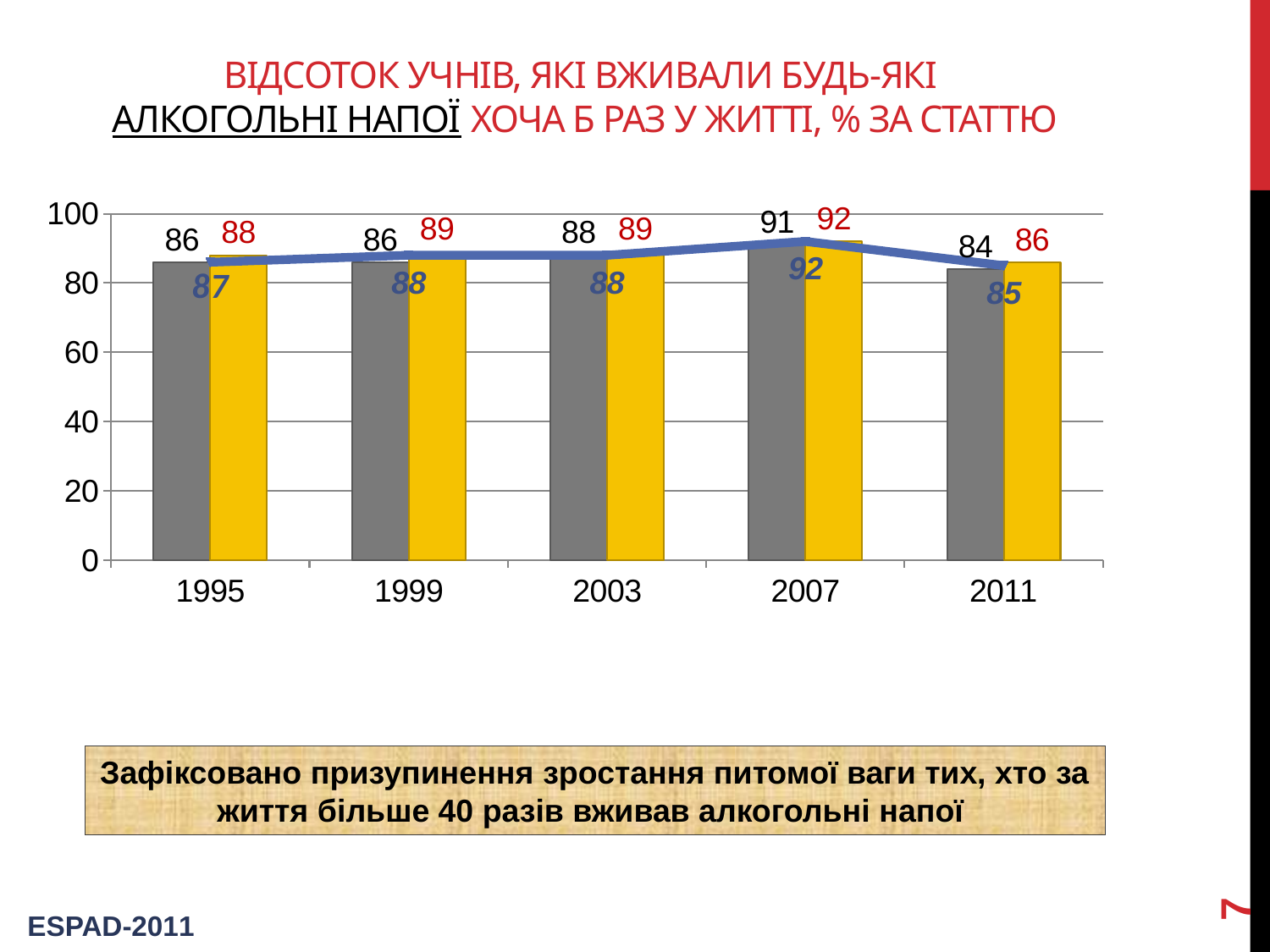
What is the value of the gray bar for 2007? 91 Does the blue line rise or fall from 2007 to 2011? fall What is the highest value shown on the y axis? 100 Which is larger in 2003, the gray bar or the yellow bar? the yellow bar What is the value of the yellow bar for 1999? 89 What is the value of the blue line at 2011? 85 Is the value of the gray bar for 2011 greater or less than 80? greater In which year is the gray bar highest? 2007 In which year is the gray bar lowest? 2011 What kind of chart is this? bar chart with a line What is the difference between the yellow bar and the gray bar in 1995? 2 How many years are shown on the x axis? 5